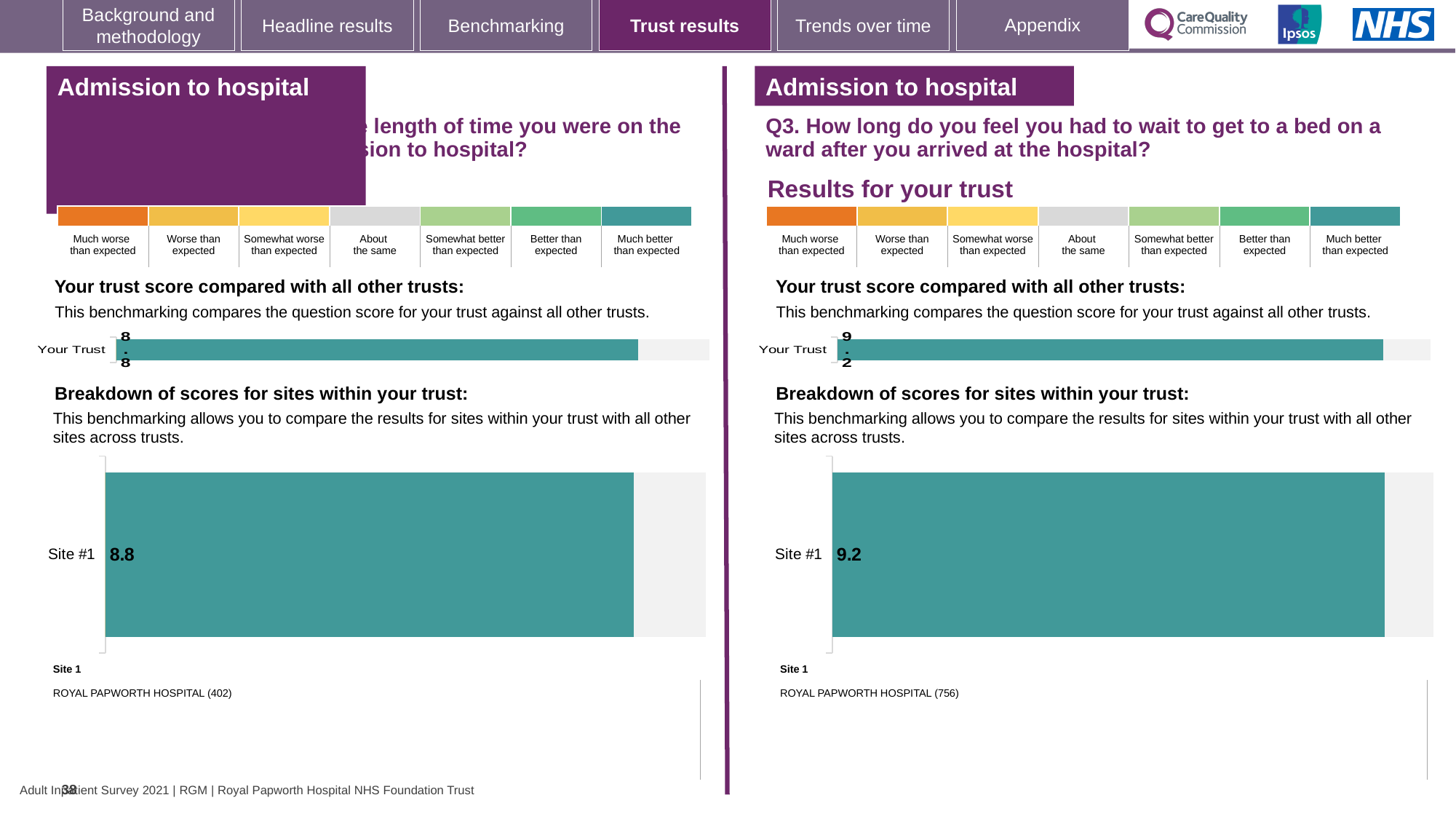
According to the colour key, which category does the teal colour of the Your Trust bar on the right half (Q3) represent? Much better than expected On the right half of the slide (Q3), what is the value shown for Your Trust in the 'Your trust score compared with all other trusts' chart? 9.2 In the right 'Breakdown of scores for sites within your trust' chart (Q3), what is the score for Site #1? 9.2 What kind of chart is used to show the Site #1 score in the 'Breakdown of scores for sites within your trust' section on the left? Bar chart Which site name is listed under Site 1 on the right half of the slide (Q3)? ROYAL PAPWORTH HOSPITAL (756) How many sites are shown in the right 'Breakdown of scores for sites within your trust' chart (Q3)? 1 Which is larger: the Your Trust score on the left half of the slide or the Your Trust score on the right half (Q3)? The right half (Q3), 9.2 On the left half of the slide, what is the value shown for Your Trust in the 'Your trust score compared with all other trusts' chart? 8.8 What is the difference between the Site #1 score in the right chart (Q3) and the Site #1 score in the left chart? 0.4 In the left 'Breakdown of scores for sites within your trust' chart, what is the score for Site #1? 8.8 How many sites are shown in the left 'Breakdown of scores for sites within your trust' chart? 1